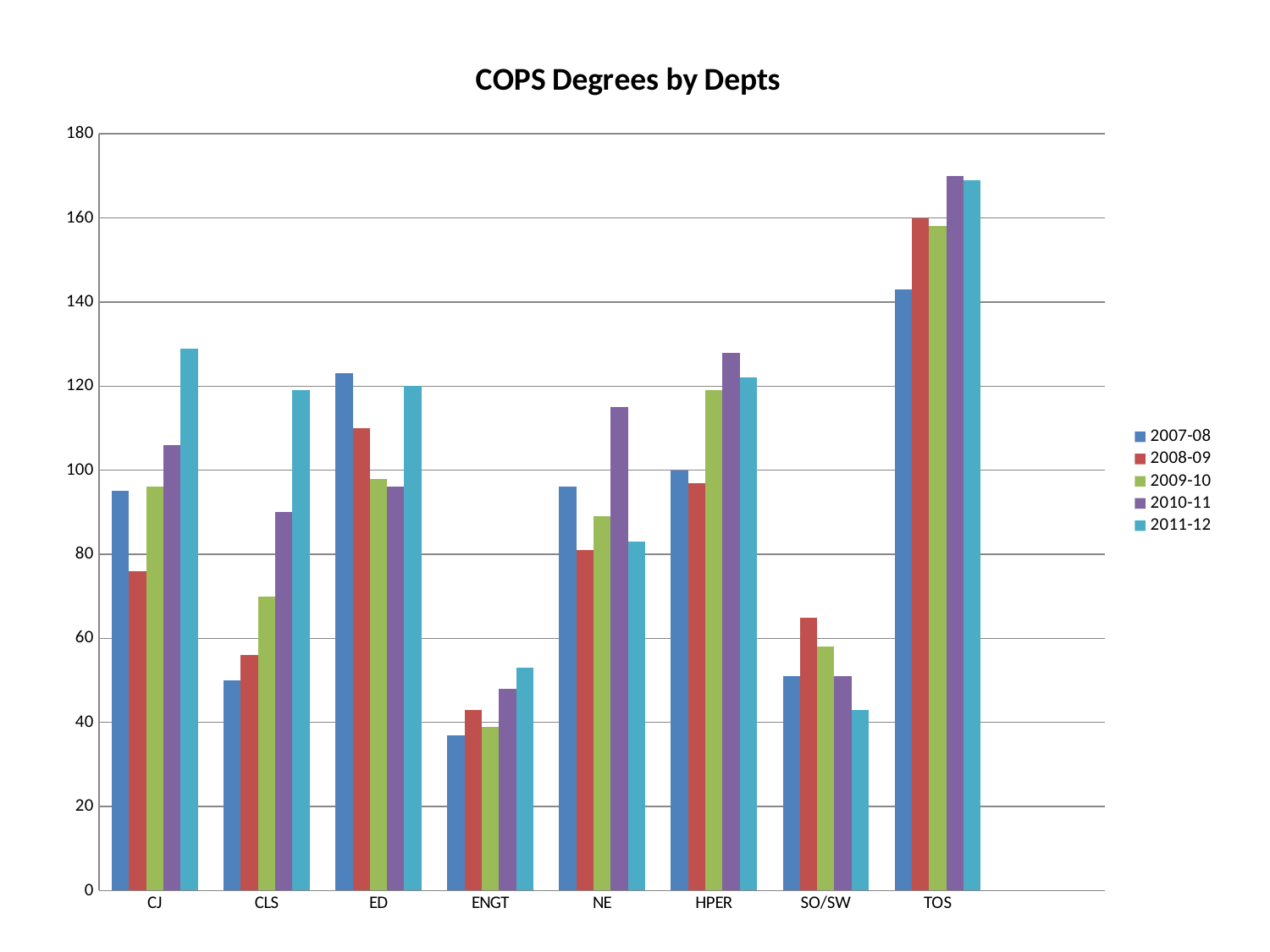
Is the value for ENGT in 2007-08 greater or less than 40? less Which department has the highest bars overall? TOS Is the value for NE in 2010-11 greater or less than 100? greater Is the value for TOS in 2010-11 greater or less than 160? greater What is the title of the chart? COPS Degrees by Depts What kind of chart is shown on the slide? bar chart For CJ, which is larger: the 2007-08 value or the 2011-12 value? 2011-12 For SO/SW, which is larger: the 2008-09 value or the 2011-12 value? 2008-09 Which department has the lowest value for 2007-08? ENGT How many departments are shown on the x axis? 8 How many series does the legend list? 5